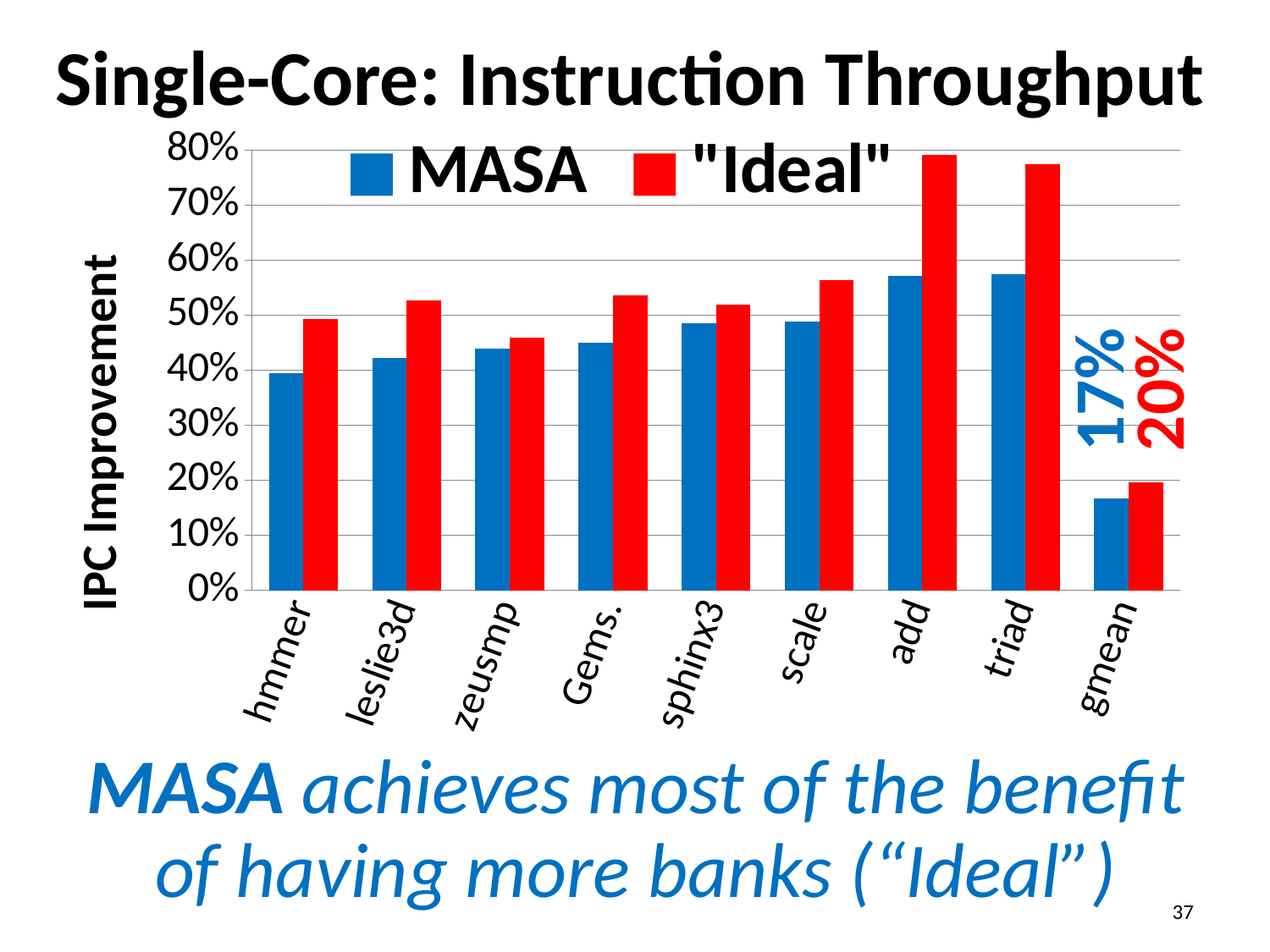
What is the label on the y axis? IPC Improvement What kind of chart is shown on the slide? Bar chart Is the "Ideal" value for zeusmp greater or less than 50%? less Excluding gmean, which benchmark has the lowest "Ideal" value? zeusmp What is the "Ideal" value for gmean? 20% What is the difference between the "Ideal" and MASA values for gmean? 3 percentage points How many categories are shown on the x axis? 9 How many series does the legend list? 2 Which is larger, the "Ideal" value for add or the "Ideal" value for hmmer? add Excluding gmean, which benchmark has the lowest MASA value? hmmer What is the MASA value for gmean? 17% Is the "Ideal" value for add greater or less than 70%? greater